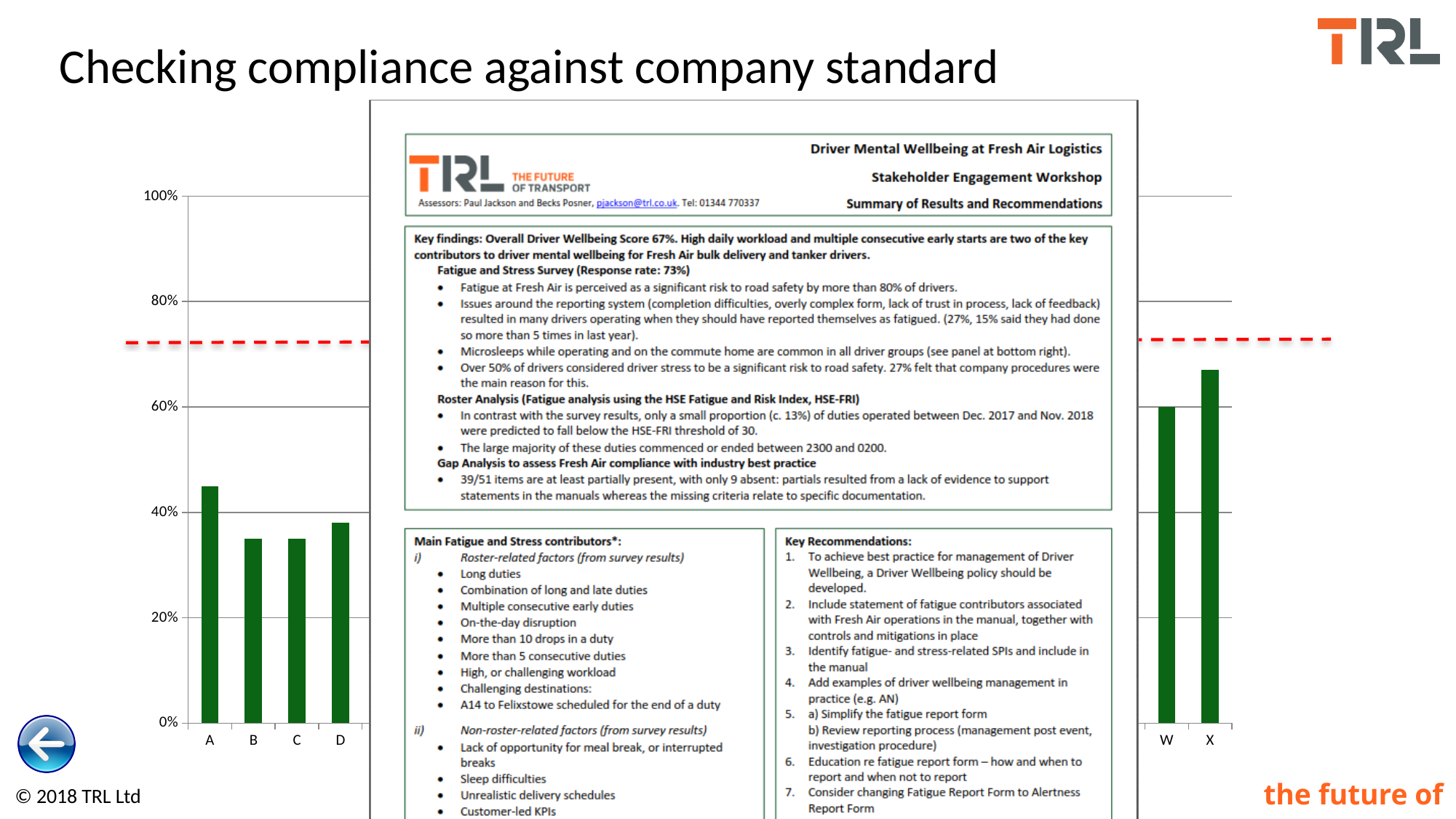
What kind of chart is shown on the slide? bar chart What colour is the dashed horizontal line drawn across the chart? red Is the value for D greater or less than 20%? greater Is the value for B greater or less than 40%? less Is the value for W greater or less than 80%? less What colour are the bars in the chart? green Among the bars visible on the slide, which category has the highest value? X Which is larger, the value for A or the value for B? A Which is larger, the value for X or the value for D? X Which is larger, the value for W or the value for A? W